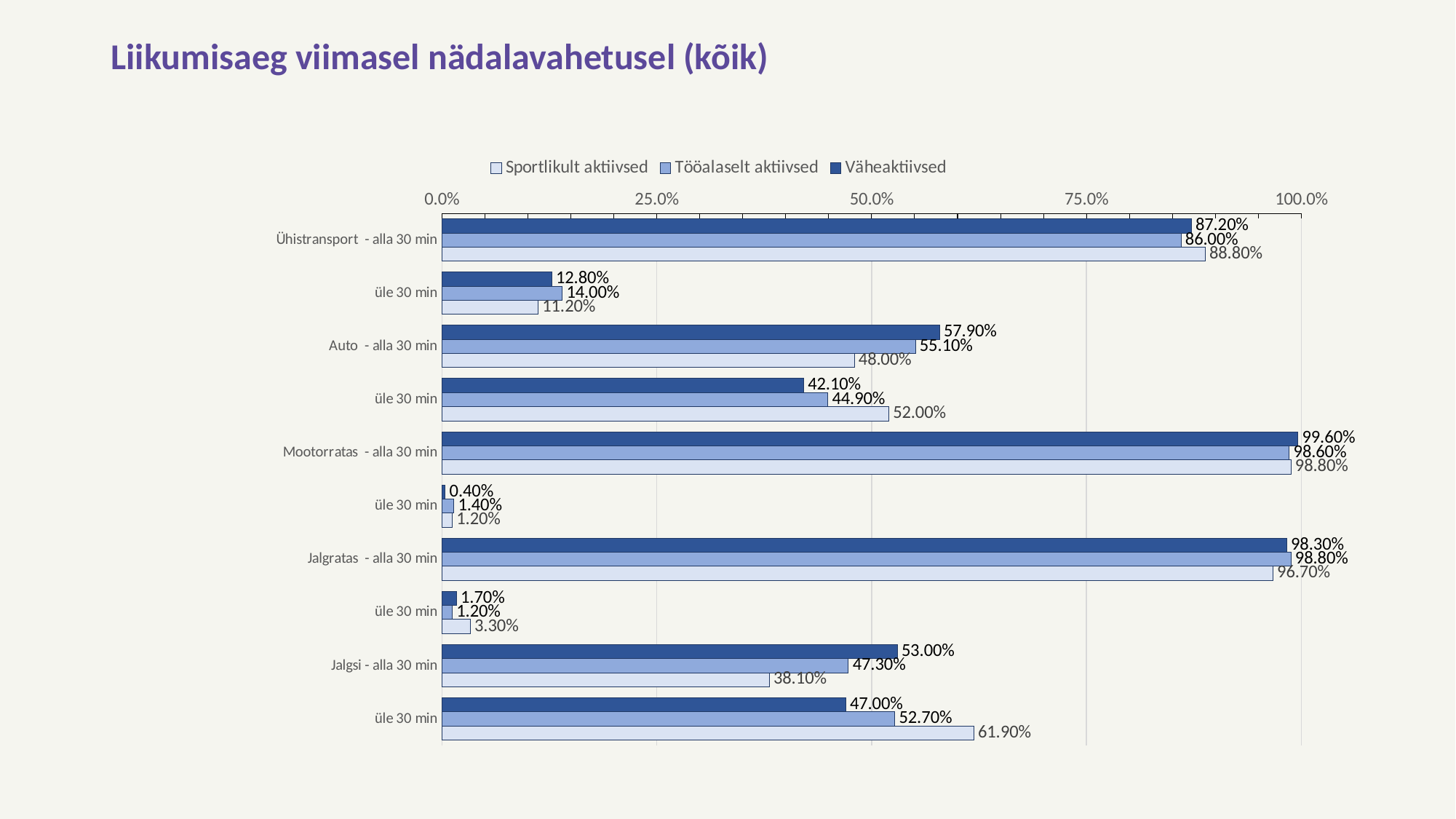
What is the title of the slide? Liikumisaeg viimasel nädalavahetusel (kõik) What is the value for Sportlikult aktiivsed in the 'Jalgsi - üle 30 min' category (the bottom category)? 61.90% What kind of chart is shown on the slide? bar chart How many categories are shown on the vertical axis of the chart? 10 What is the value for Tööalaselt aktiivsed in the 'Auto - alla 30 min' category? 55.10% What is the difference between the Sportlikult aktiivsed and Väheaktiivsed values in the 'Jalgsi - alla 30 min' category? 14.90% How many series does the legend list? 3 Which category has the lowest value for Väheaktiivsed? Mootorratas - üle 30 min Is the Sportlikult aktiivsed value for 'Jalgsi - alla 30 min' greater or less than 50.0%? less In the 'Auto - üle 30 min' category, which series has the larger value: Sportlikult aktiivsed or Väheaktiivsed? Sportlikult aktiivsed Which category has the highest value for Väheaktiivsed? Mootorratas - alla 30 min What is the value for Väheaktiivsed in the 'Ühistransport - alla 30 min' category? 87.20%